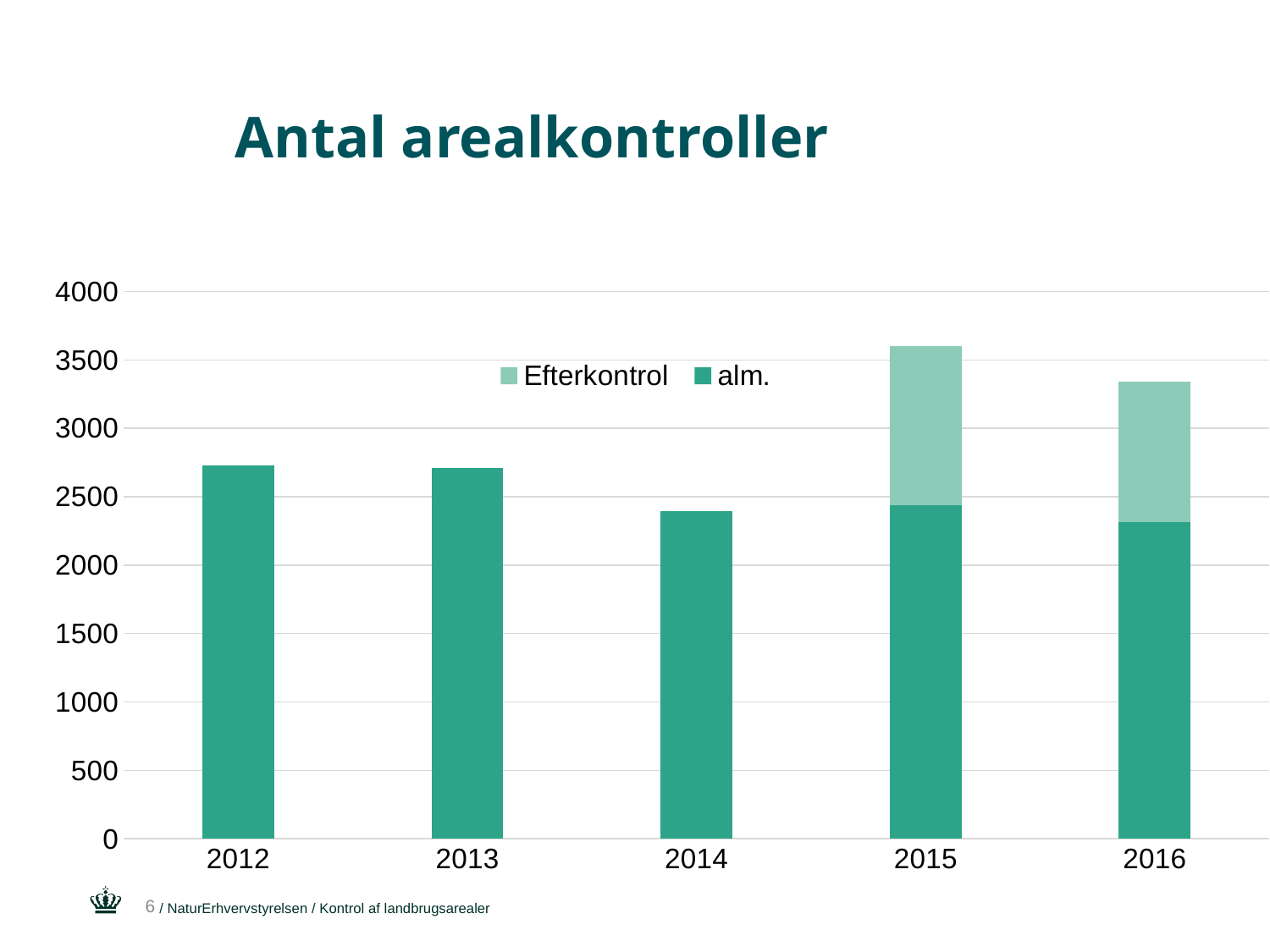
Is the value for alm. in 2012 greater or less than 2500? greater Which year has the highest total bar? 2015 How many years are shown on the x axis of the chart? 5 Is the value for alm. in 2014 greater or less than 2500? less What is the title of the chart? Antal arealkontroller Is the total value for 2015 greater or less than 3500? greater Does the alm. value rise or fall from 2012 to 2014? fall How many series does the legend list? 2 Which year has the lowest total bar? 2014 Which series is shown in the lighter green colour? Efterkontrol What kind of chart is shown on the slide? Stacked bar chart Which is larger, the alm. value for 2012 or for 2014? 2012